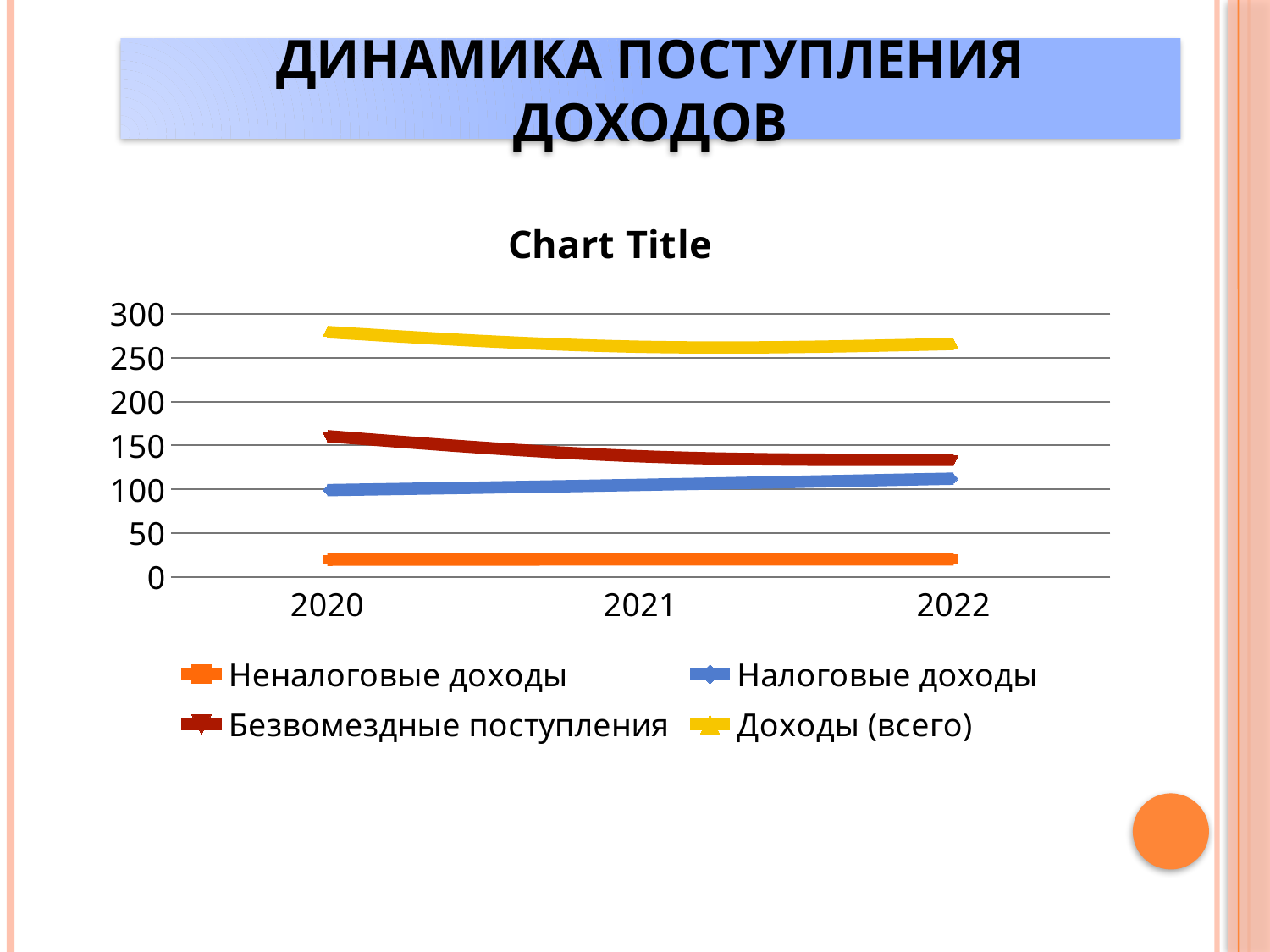
Is the value for Безвозмездные поступления in 2020 greater or less than 150? greater Is the value for Доходы (всего) in 2020 greater or less than 250? greater How many series does the legend list? 4 Which series has the lowest values across all years? Неналоговые доходы What colour is the line for Доходы (всего)? yellow What kind of chart is shown on the slide? line chart In 2020, which is larger: Безвозмездные поступления or Налоговые доходы? Безвозмездные поступления Do the values for Налоговые доходы rise or fall from 2020 to 2022? rise How many years are shown on the x axis? 3 Is the value for Неналоговые доходы in 2021 greater or less than 50? less Do the values for Безвозмездные поступления rise or fall from 2020 to 2022? fall Which series has the highest values across all years? Доходы (всего)